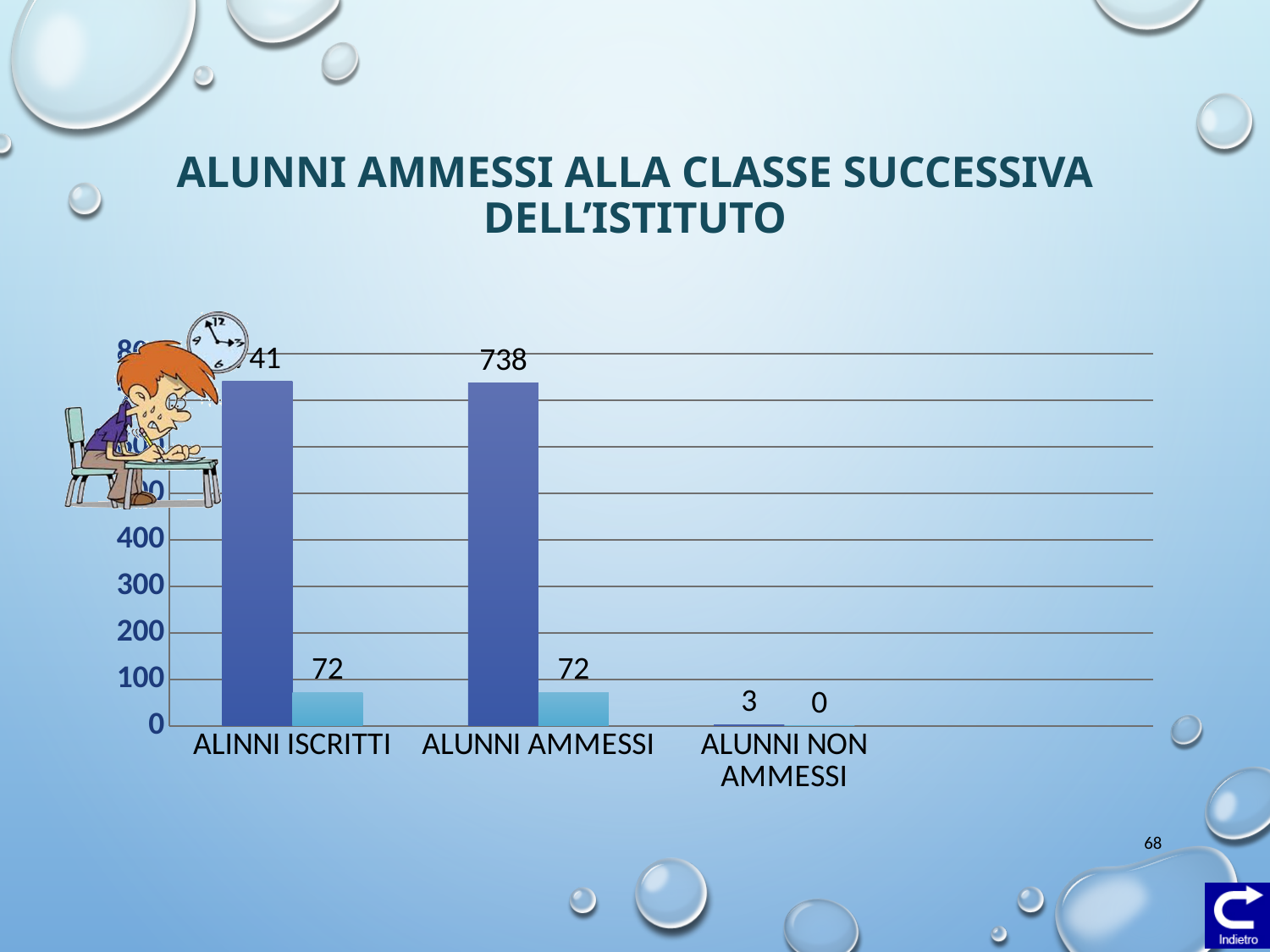
What is the value of the light blue bar for ALINNI ISCRITTI? 72 What is the difference between the dark blue values for ALUNNI AMMESSI and ALUNNI NON AMMESSI? 735 What is the value of the light blue bar for ALUNNI AMMESSI? 72 Is the dark blue bar for ALINNI ISCRITTI greater or less than 400? greater Which category has the lowest dark blue bar? ALUNNI NON AMMESSI How many categories are shown on the x axis of the chart? 3 Which has the larger dark blue bar, ALUNNI AMMESSI or ALUNNI NON AMMESSI? ALUNNI AMMESSI What is the title of the chart on the slide? ALUNNI AMMESSI ALLA CLASSE SUCCESSIVA DELL'ISTITUTO What kind of chart is shown on the slide? bar chart What is the value of the dark blue bar for ALUNNI NON AMMESSI? 3 What is the value of the dark blue bar for ALUNNI AMMESSI? 738 What is the value of the light blue bar for ALUNNI NON AMMESSI? 0